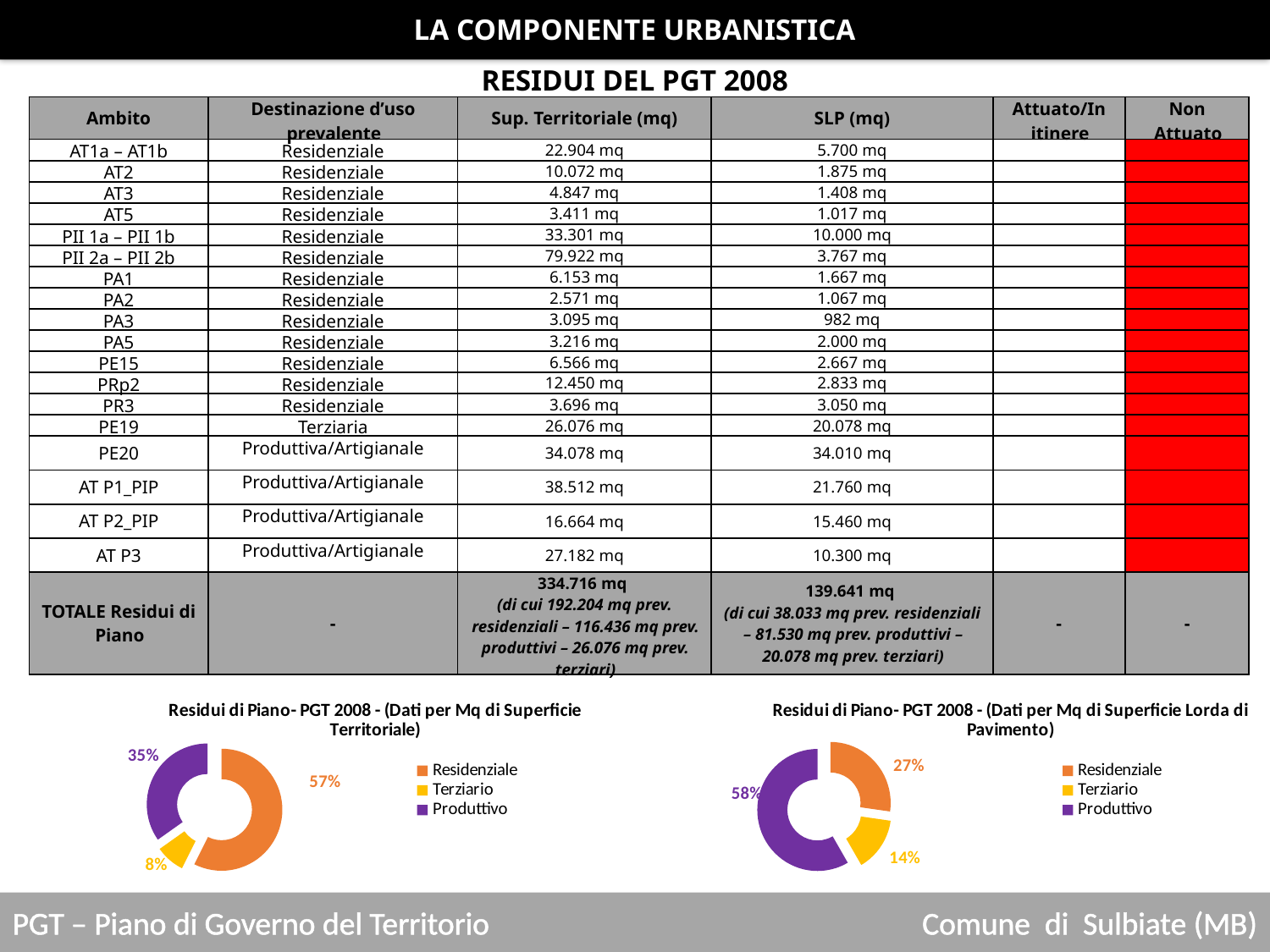
In the left chart (Dati per Mq di Superficie Territoriale), what share does Produttivo have? 35% In the right chart (Dati per Mq di Superficie Lorda di Pavimento), what share does Residenziale have? 27% In the right chart (Dati per Mq di Superficie Lorda di Pavimento), what is the difference between the Produttivo and Residenziale shares? 31% In the right chart (Dati per Mq di Superficie Lorda di Pavimento), what share does Terziario have? 14% What type of chart is the left chart (Dati per Mq di Superficie Territoriale)? Doughnut chart In the left chart (Dati per Mq di Superficie Territoriale), which is larger, Produttivo or Terziario? Produttivo How many categories does the legend of the right chart (Dati per Mq di Superficie Lorda di Pavimento) list? 3 In the left chart (Dati per Mq di Superficie Territoriale), which category has the largest share? Residenziale In the right chart (Dati per Mq di Superficie Lorda di Pavimento), which category has the smallest share? Terziario